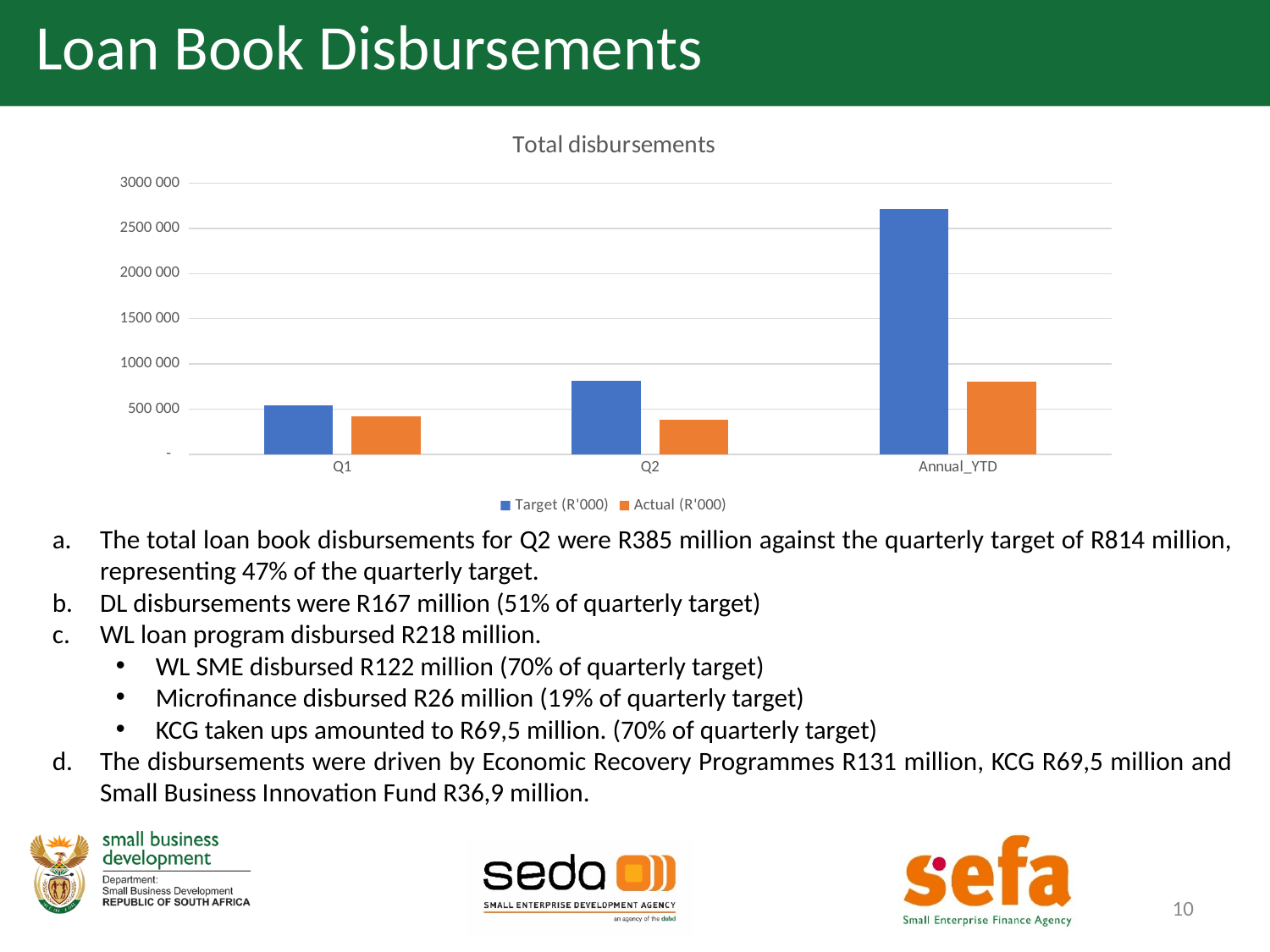
How many categories are shown on the x axis of the chart? 3 Is the Actual (R'000) value for Q2 greater or less than 500 000? less Which category has the lowest Target (R'000) value? Q1 Do the Target (R'000) values rise or fall from Q1 to Annual_YTD along the x axis? rise Is the Target (R'000) value for Q2 greater or less than 500 000? greater Is the Target (R'000) value for Annual_YTD greater or less than 2500 000? greater Which is larger, the Target (R'000) value for Q2 or the Target (R'000) value for Q1? Q2 How many series does the chart legend list? 2 Which category has the highest Target (R'000) value? Annual_YTD What is the title of the chart? Total disbursements What kind of chart is shown on the slide? bar chart